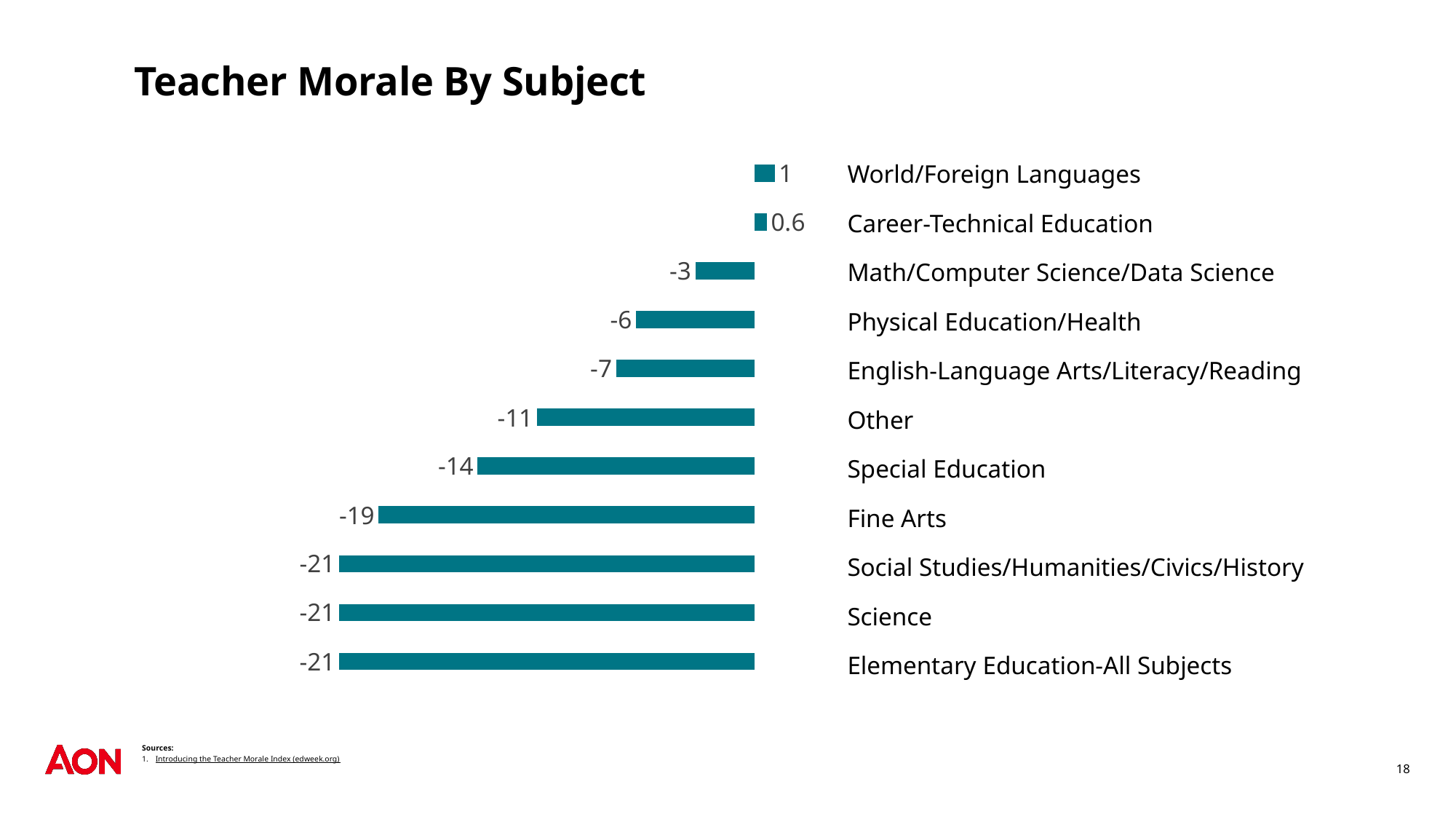
Which subject has the highest teacher morale value? World/Foreign Languages What is the difference between the values for Other and Physical Education/Health? 5 Which has a lower teacher morale value, English-Language Arts/Literacy/Reading or Other? Other Which has a higher teacher morale value, Fine Arts or Special Education? Special Education How many subjects share the lowest value of -21? 3 What is the teacher morale value for Special Education? -14 What is the difference between the values for World/Foreign Languages and Elementary Education-All Subjects? 22 What is the teacher morale value for Math/Computer Science/Data Science? -3 What is the teacher morale value for Career-Technical Education? 0.6 What is the teacher morale value for Fine Arts? -19 What kind of chart is shown on the slide? Bar chart How many subjects are shown in the chart? 11